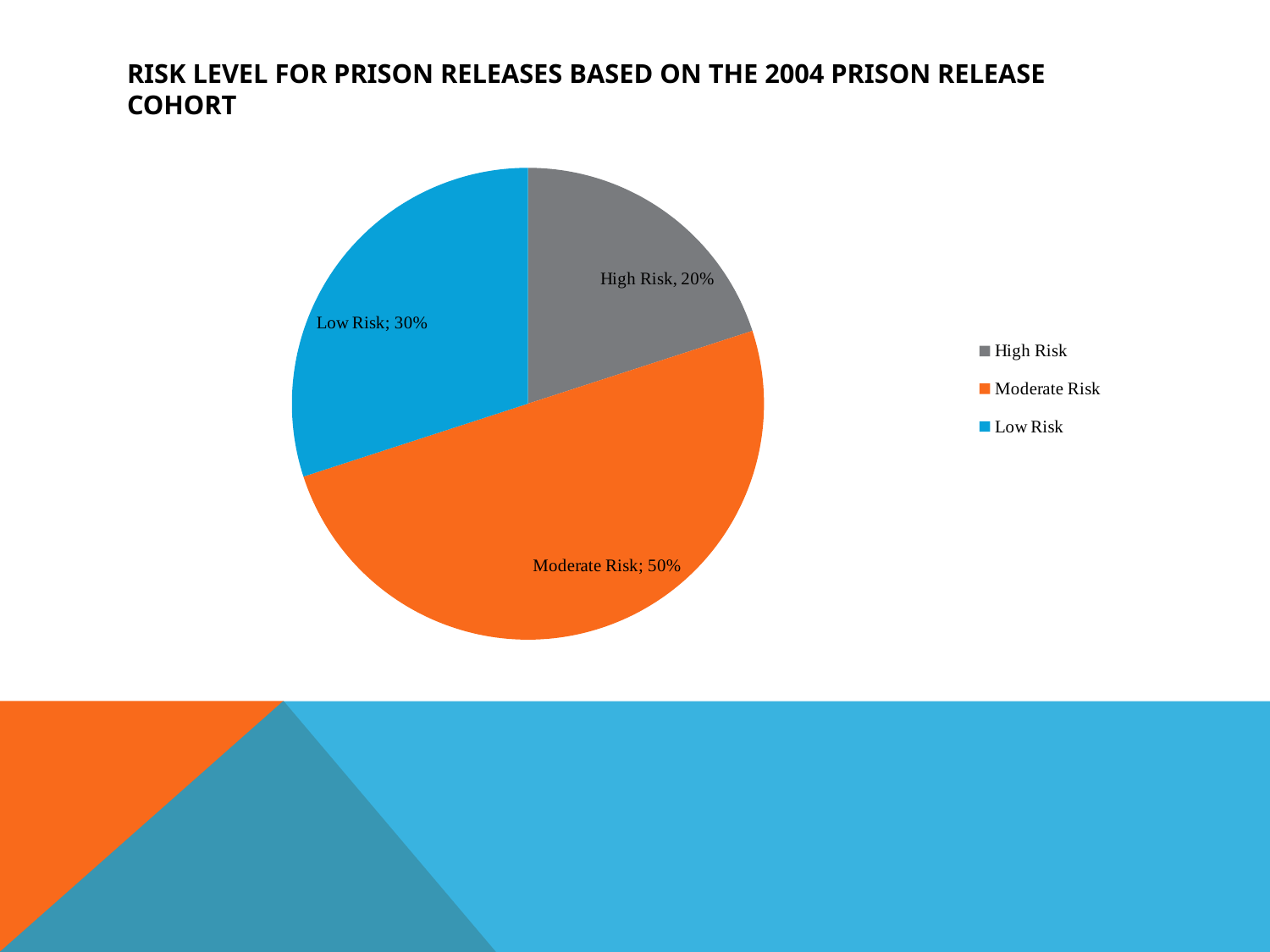
What percentage of prison releases are classified as Moderate Risk? 50% What percentage of prison releases are classified as High Risk? 20% How many categories does the pie chart show? 3 Which risk level has the smallest share of the pie? High Risk What type of chart is shown on the slide? pie chart Which risk level has the largest share of the pie? Moderate Risk What is the title of the chart? Risk Level for Prison Releases Based on the 2004 Prison Release Cohort Which is larger, the Low Risk slice or the High Risk slice? Low Risk What colour is the Moderate Risk slice? orange What percentage of prison releases are classified as Low Risk? 30% What is the difference in percentage points between the Low Risk and High Risk slices? 10 What is the difference in percentage points between the Moderate Risk and Low Risk slices? 20